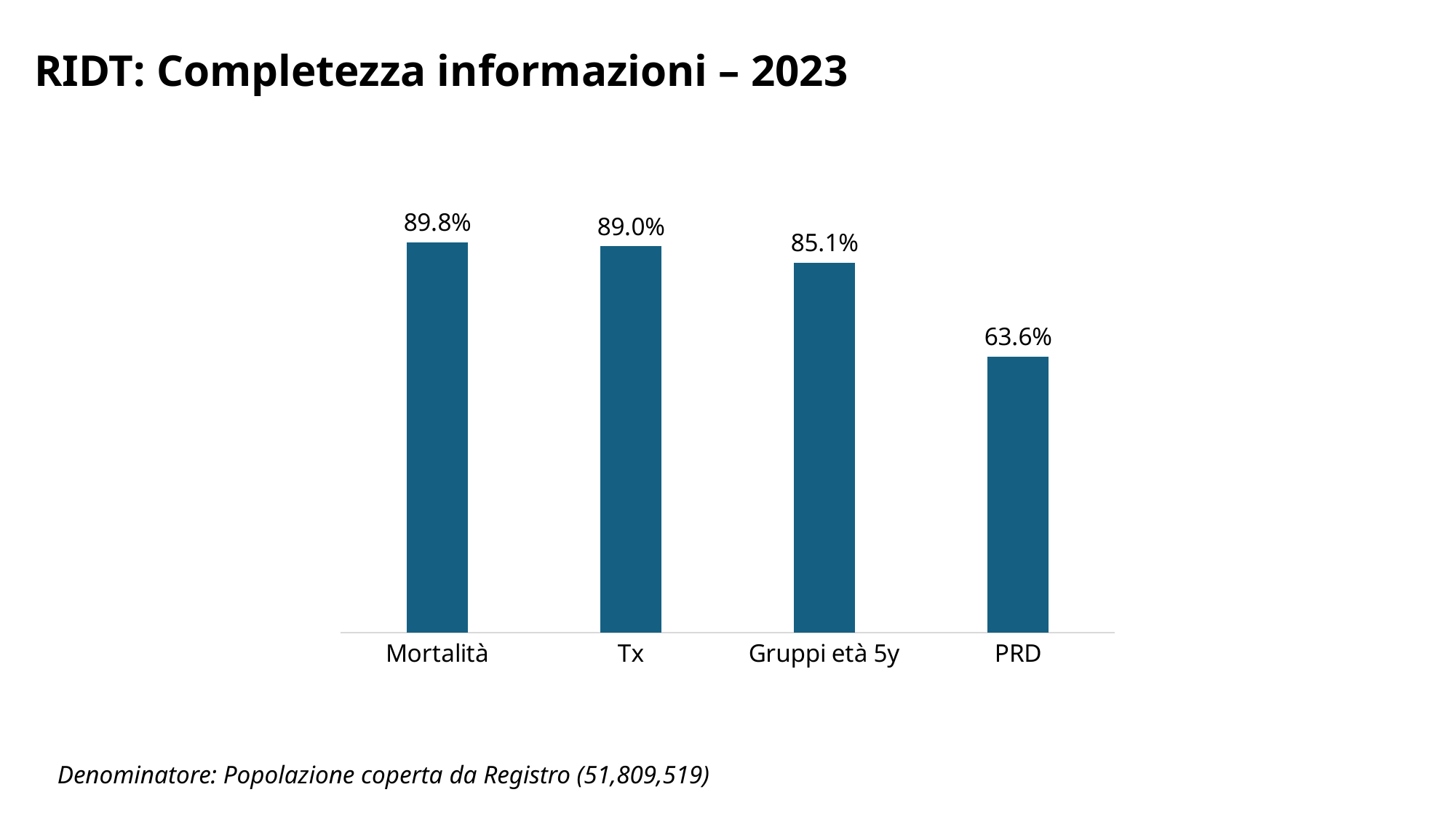
How many categories are shown in the chart? 4 What is the title of the slide? RIDT: Completezza informazioni – 2023 What is the difference between the values for Mortalità and PRD? 26.2% What is the value for Mortalità? 89.8% Which is larger, the value for Gruppi età 5y or the value for PRD? Gruppi età 5y What is the value for PRD? 63.6% What is the value for Gruppi età 5y? 85.1% Which category has the highest value? Mortalità What kind of chart is shown on the slide? Bar chart What is the value for Tx? 89.0% What is the difference between the values for Tx and Gruppi età 5y? 3.9% Which category has the lowest value? PRD